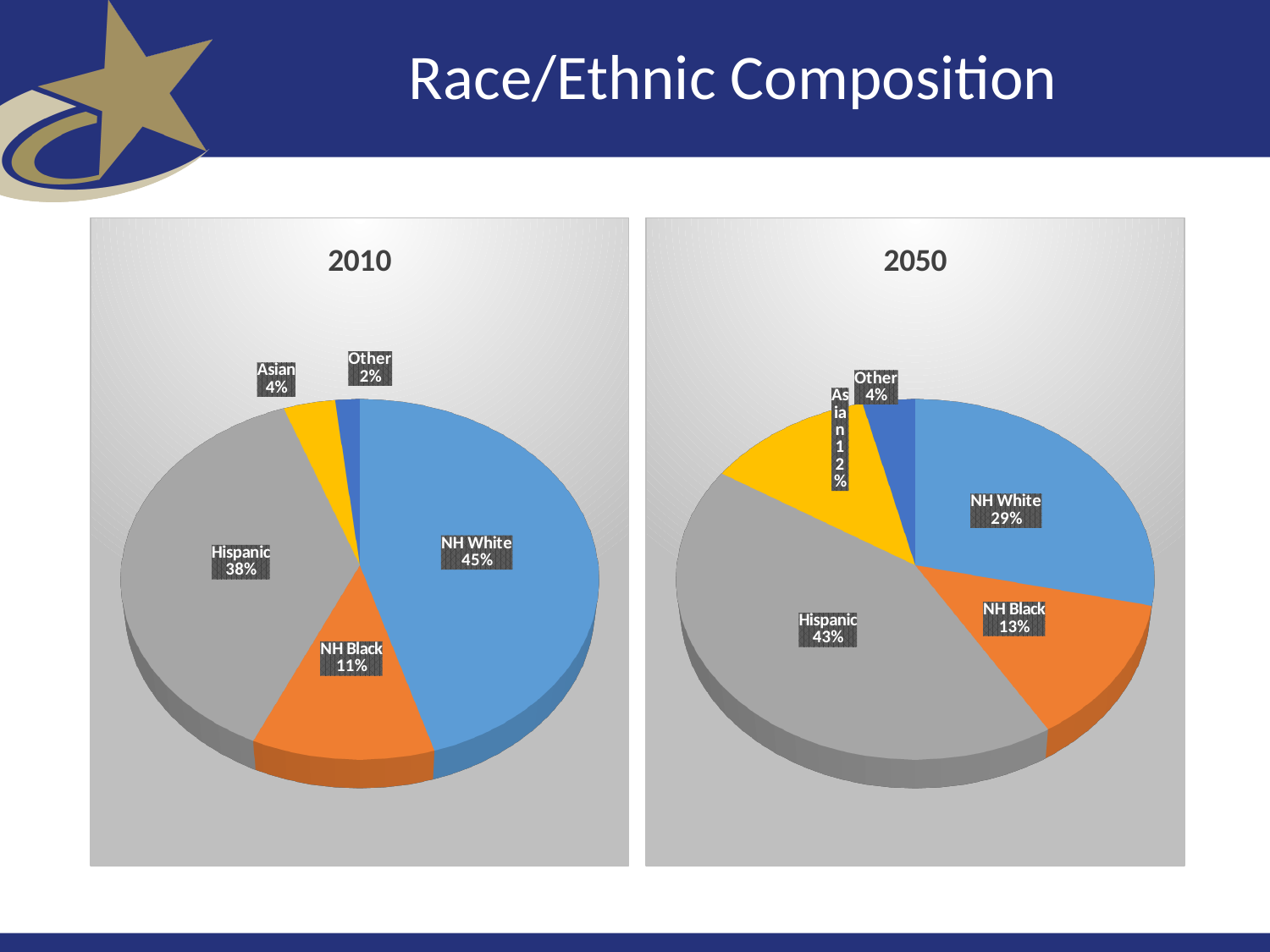
In the 2050 pie chart, what is the difference between the Hispanic share and the NH White share? 14% In the 2050 pie chart, which category has the largest share? Hispanic In the 2010 pie chart, is the Hispanic share or the NH White share larger? NH White What is the title of the slide containing the two charts? Race/Ethnic Composition In the 2010 pie chart, what share is NH White? 45% In the 2010 pie chart, which category has the largest share? NH White In the 2050 pie chart, what share is Asian? 12% How many categories does the 2050 pie chart show? 5 In the 2050 pie chart, what share is Hispanic? 43% In the 2010 pie chart, what share is NH Black? 11% In the 2010 pie chart, which category has the smallest share? Other What type of chart is used for the 2010 data? Pie chart